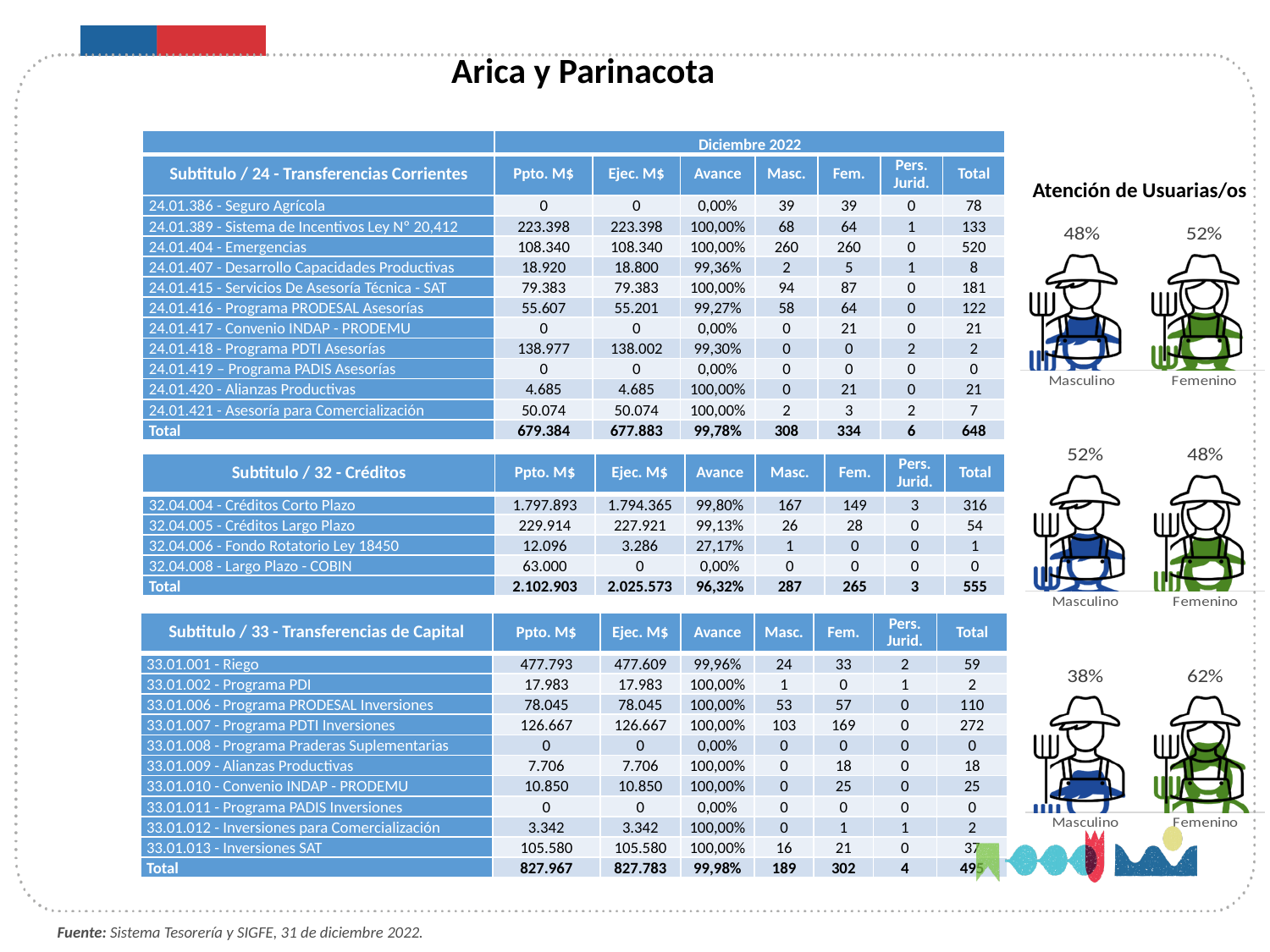
In the bottom pictogram chart on the right side of the slide, what percentage is shown for Femenino? 62% What is the title above the pictogram charts on the right side of the slide? Atención de Usuarias/os How many categories does each pictogram chart on the right side of the slide show? 2 In the bottom pictogram chart on the right side of the slide, what is the difference in percentage points between Femenino and Masculino? 24 In the bottom pictogram chart on the right side of the slide, which category has the higher percentage, Masculino or Femenino? Femenino In the top 'Atención de Usuarias/os' pictogram chart, what percentage is shown for Femenino? 52% In the pictogram charts on the right side of the slide, what colour is used for the Femenino figure? Green In the middle pictogram chart on the right side of the slide, what percentage is shown for Masculino? 52% In the top 'Atención de Usuarias/os' pictogram chart, what percentage is shown for Masculino? 48% In the bottom pictogram chart on the right side of the slide, what percentage is shown for Masculino? 38% In the middle pictogram chart on the right side of the slide, which category has the higher percentage, Masculino or Femenino? Masculino In the middle pictogram chart on the right side of the slide, what percentage is shown for Femenino? 48%